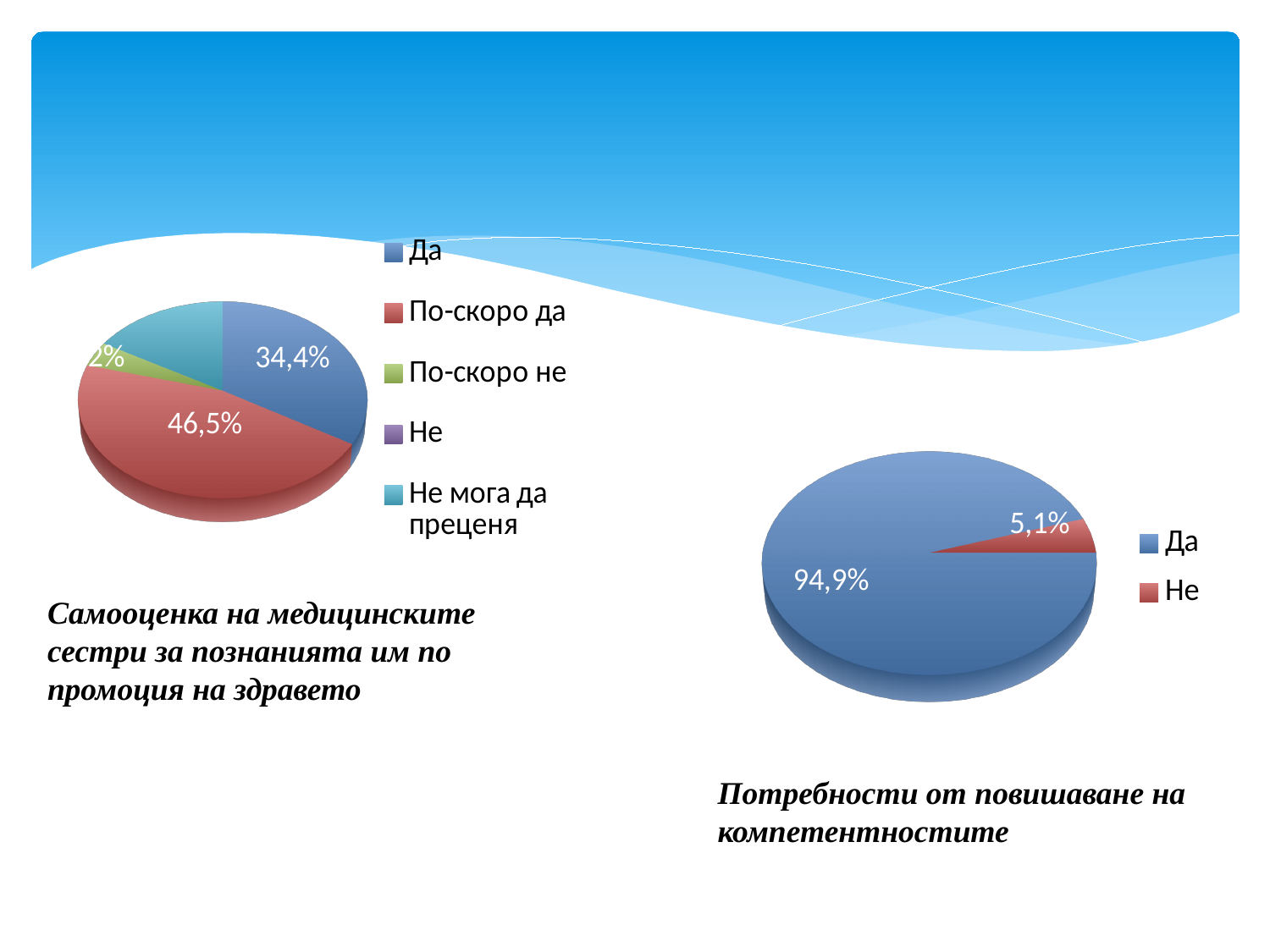
In the chart titled 'Самооценка на медицинските сестри за познанията им по промоция на здравето', what is the difference between the 'По-скоро да' and 'Да' shares? 12,1% What kind of chart is the one titled 'Самооценка на медицинските сестри за познанията им по промоция на здравето'? Pie chart In the chart titled 'Потребности от повишаване на компетентностите', how many entries does the legend list? 2 In the chart titled 'Самооценка на медицинските сестри за познанията им по промоция на здравето', what percentage is shown for 'По-скоро да'? 46,5% In the chart titled 'Самооценка на медицинските сестри за познанията им по промоция на здравето', which category has the largest slice? По-скоро да What kind of chart is the one titled 'Потребности от повишаване на компетентностите'? Pie chart In the chart titled 'Потребности от повишаване на компетентностите', what is the difference between the 'Да' and 'Не' shares? 89,8% In the chart titled 'Самооценка на медицинските сестри за познанията им по промоция на здравето', which is larger: 'Да' or 'По-скоро да'? По-скоро да In the chart titled 'Потребности от повишаване на компетентностите', what percentage is shown for 'Не'? 5,1% In the chart titled 'Самооценка на медицинските сестри за познанията им по промоция на здравето', what percentage is shown for 'Да'? 34,4% In the chart titled 'Самооценка на медицинските сестри за познанията им по промоция на здравето', how many entries does the legend list? 5 In the chart titled 'Потребности от повишаване на компетентностите', what percentage is shown for 'Да'? 94,9%